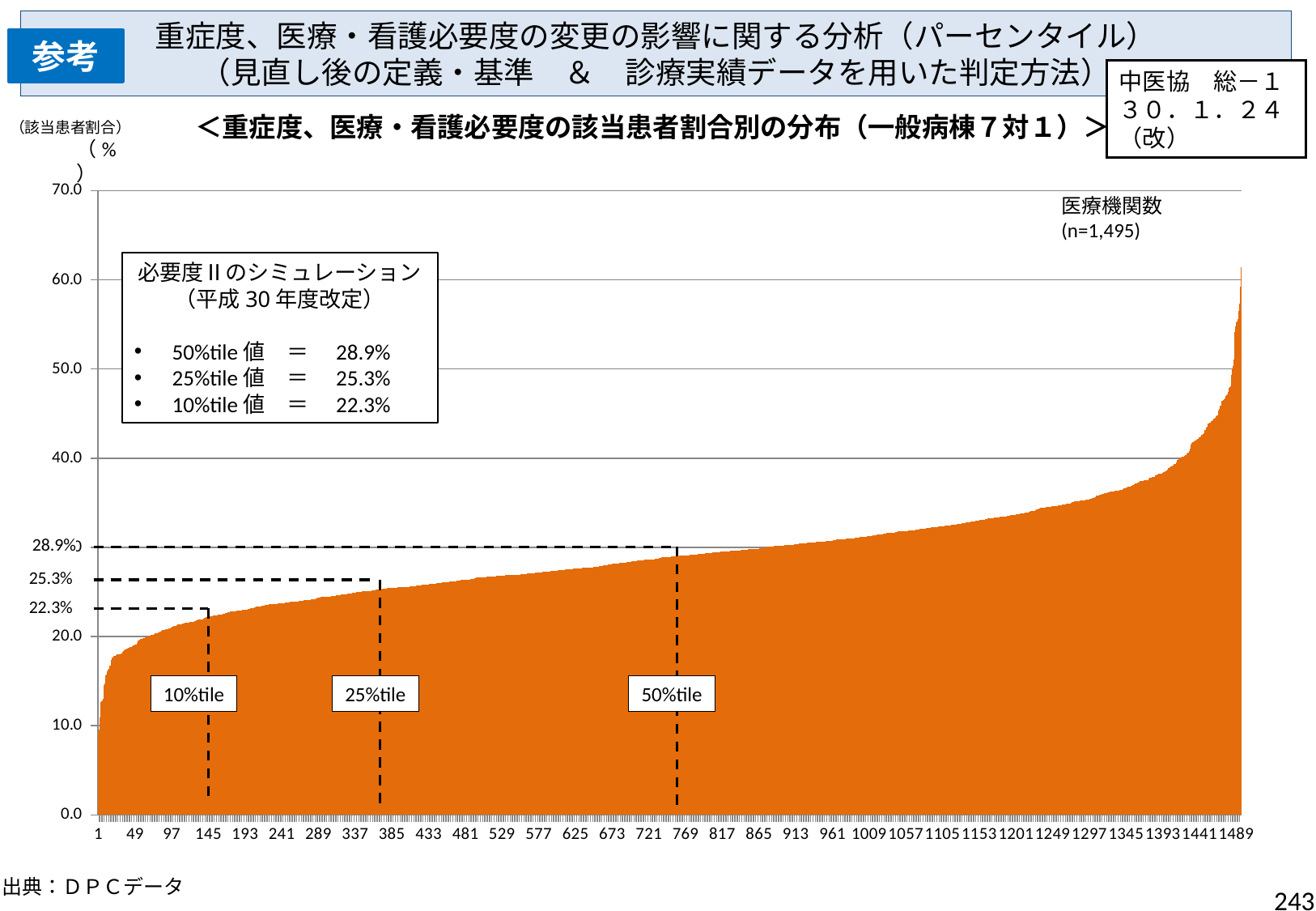
What kind of chart is shown on the slide? Bar chart What is the 50%tile value shown in the simulation box on the chart? 28.9% What is the 25%tile value shown in the simulation box on the chart? 25.3% What is the difference between the 50%tile value and the 10%tile value? 6.6 percentage points Do the values rise or fall from left to right along the x axis? Rise What is the highest tick value shown on the y axis of the chart? 70.0 What is the difference between the 50%tile value and the 25%tile value? 3.6 percentage points Which is larger, the 25%tile value or the 10%tile value? 25%tile value Is the highest value at the right end of the chart greater or less than 50? greater What data source is cited below the chart? ＤＰＣデータ What is the 10%tile value shown in the simulation box on the chart? 22.3% How many medical institutions (n) are included in the chart? 1,495